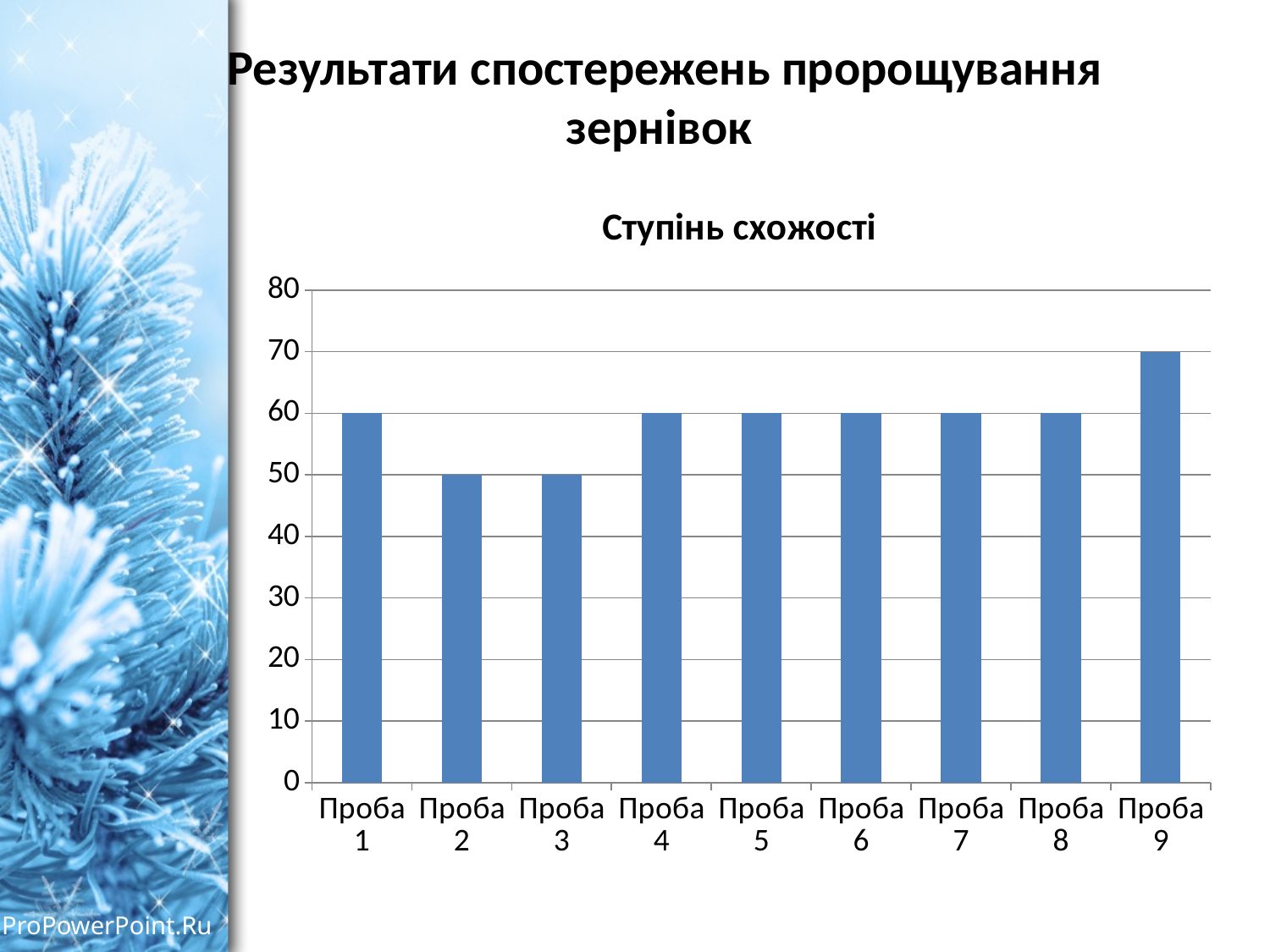
What is the value for Проба 9? 70 Is the value for Проба 3 greater or less than 60? less What is the maximum value shown on the vertical axis? 80 Is the value for Проба 9 greater or less than 60? greater What is the difference between the values for Проба 9 and Проба 3? 20 How many categories (проби) are plotted on the chart? 9 Which category has the highest value? Проба 9 What kind of chart is shown on the slide? bar chart What is the value for Проба 1? 60 What is the title of the chart? Ступінь схожості What is the value for Проба 2? 50 Which is larger, the value for Проба 4 or the value for Проба 2? Проба 4